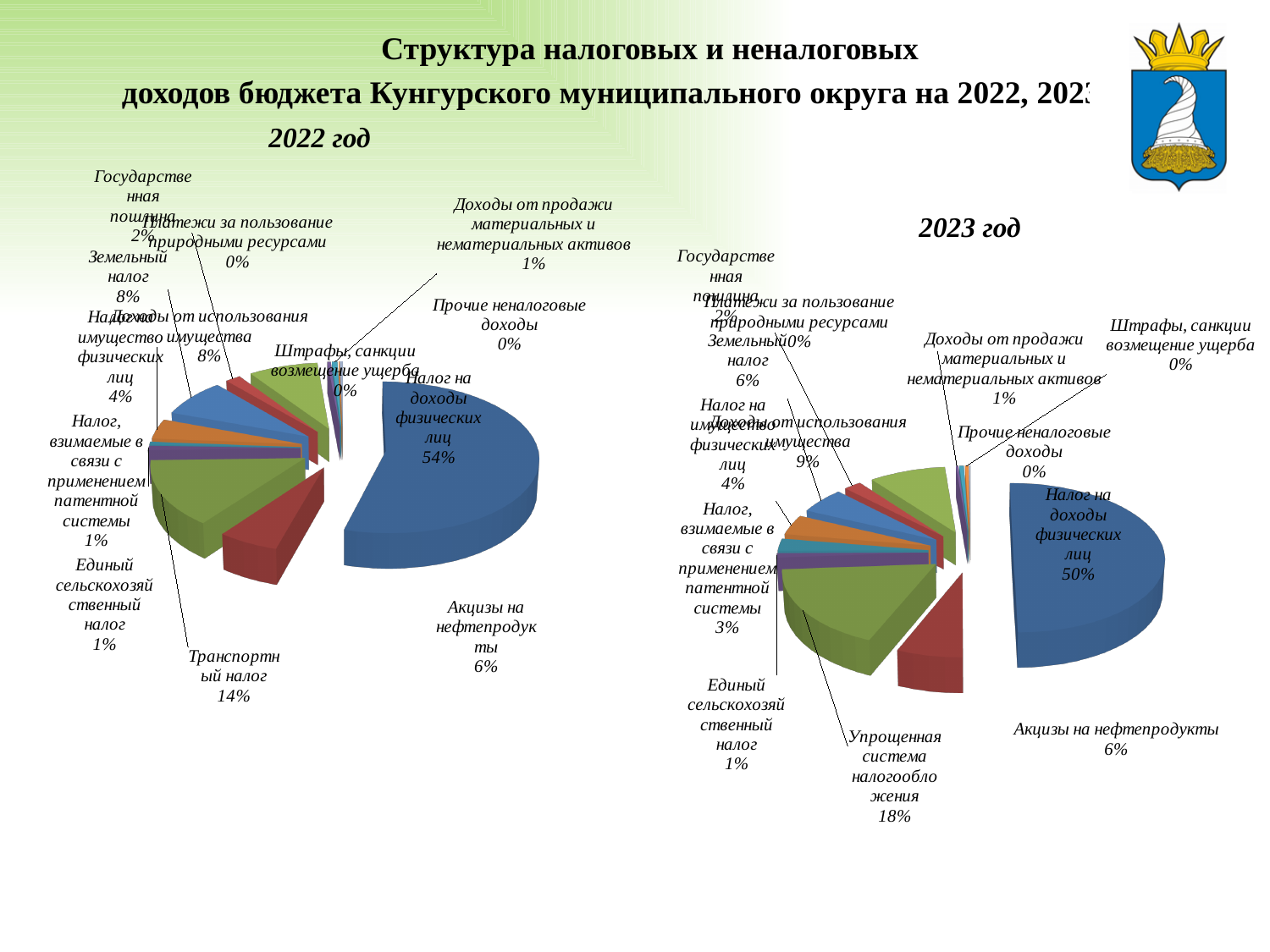
In the 2023 год chart, what is the value for Упрощенная система налогообложения? 18% In the 2023 год chart, which is larger: Доходы от использования имущества or Земельный налог? Доходы от использования имущества In the 2022 год chart, what is the difference between Налог на доходы физических лиц and Транспортный налог? 40% What kind of chart is used for the 2022 год data? pie chart In the 2023 год chart, which category has the largest share? Налог на доходы физических лиц How many categories are shown in the 2023 год chart? 13 In the 2022 год chart, what is the value for Транспортный налог? 14% In the 2023 год chart, what is the value for Налог, взимаемые в связи с применением патентной системы? 3% In the 2022 год chart, what is the value for Акцизы на нефтепродукты? 6% In the 2023 год chart, what share does Налог на доходы физических лиц have? 50% In the 2022 год chart, what share does Налог на доходы физических лиц have? 54% In the 2022 год chart, what is the value for Земельный налог? 8%